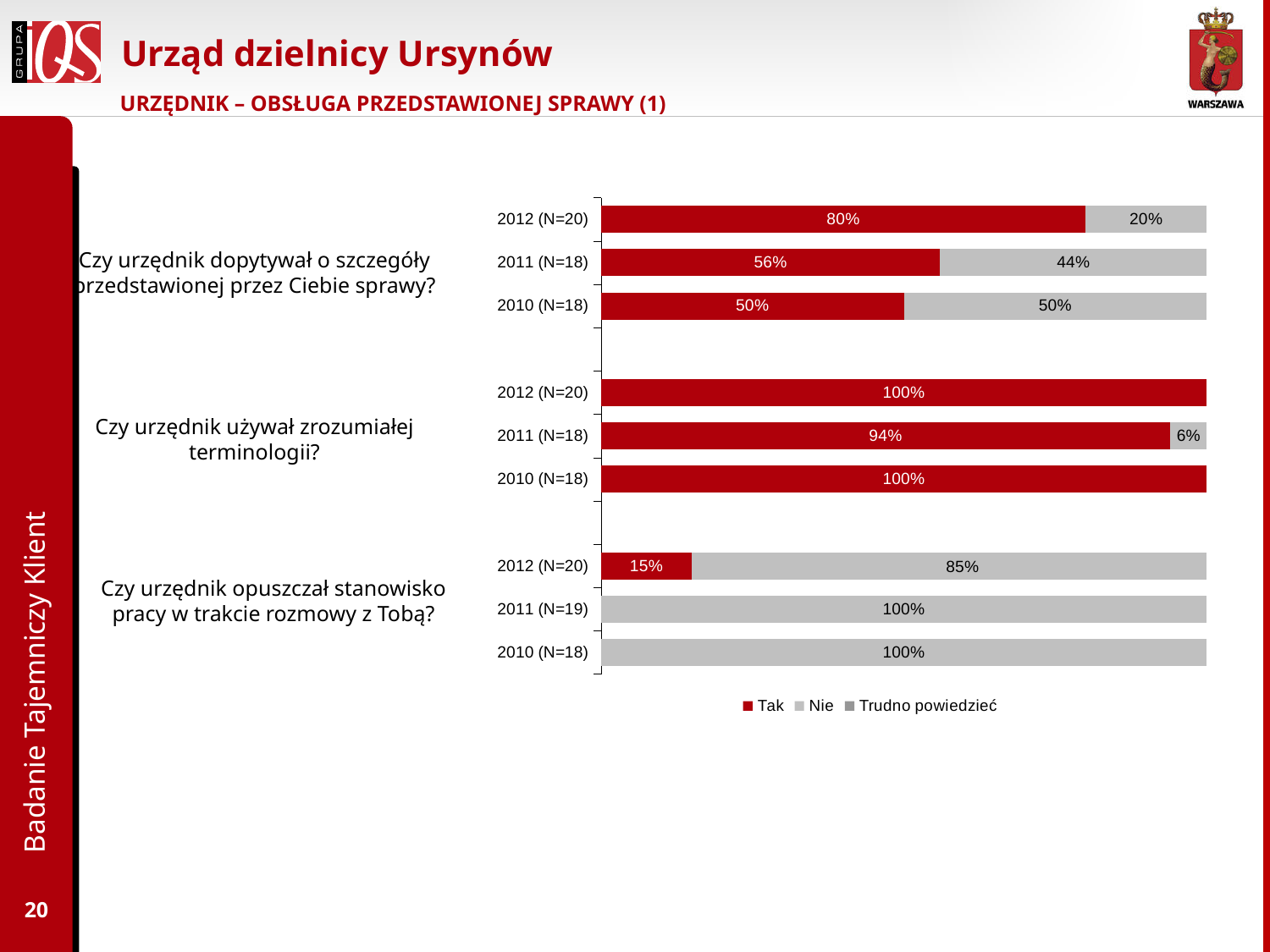
What percentage answered "Nie" in 2011 (N=18) for the question "Czy urzędnik używał zrozumiałej terminologii?"? 6% What percentage answered "Tak" in 2012 (N=20) for the question "Czy urzędnik opuszczał stanowisko pracy w trakcie rozmowy z Tobą?"? 15% For the question "Czy urzędnik używał zrozumiałej terminologii?", is the "Tak" share larger in 2012 (N=20) or in 2011 (N=18)? 2012 (N=20) What kind of chart is shown on the slide? Stacked bar chart For the question "Czy urzędnik dopytywał o szczegóły przedstawionej przez Ciebie sprawy?", which year has the highest "Tak" share? 2012 (N=20) What are the three legend entries of the chart? Tak, Nie, Trudno powiedzieć How many series does the legend list? 3 For the question "Czy urzędnik dopytywał o szczegóły przedstawionej przez Ciebie sprawy?", does the "Tak" share rise or fall from 2010 to 2012? Rise For the question "Czy urzędnik dopytywał o szczegóły przedstawionej przez Ciebie sprawy?", which year has the lowest "Tak" share? 2010 (N=18) For the question "Czy urzędnik dopytywał o szczegóły przedstawionej przez Ciebie sprawy?", what is the difference in the "Tak" share between 2012 (N=20) and 2011 (N=18)? 24 percentage points What percentage answered "Nie" in 2011 (N=18) for the question "Czy urzędnik dopytywał o szczegóły przedstawionej przez Ciebie sprawy?"? 44% What percentage answered "Tak" in 2012 (N=20) for the question "Czy urzędnik dopytywał o szczegóły przedstawionej przez Ciebie sprawy?"? 80%